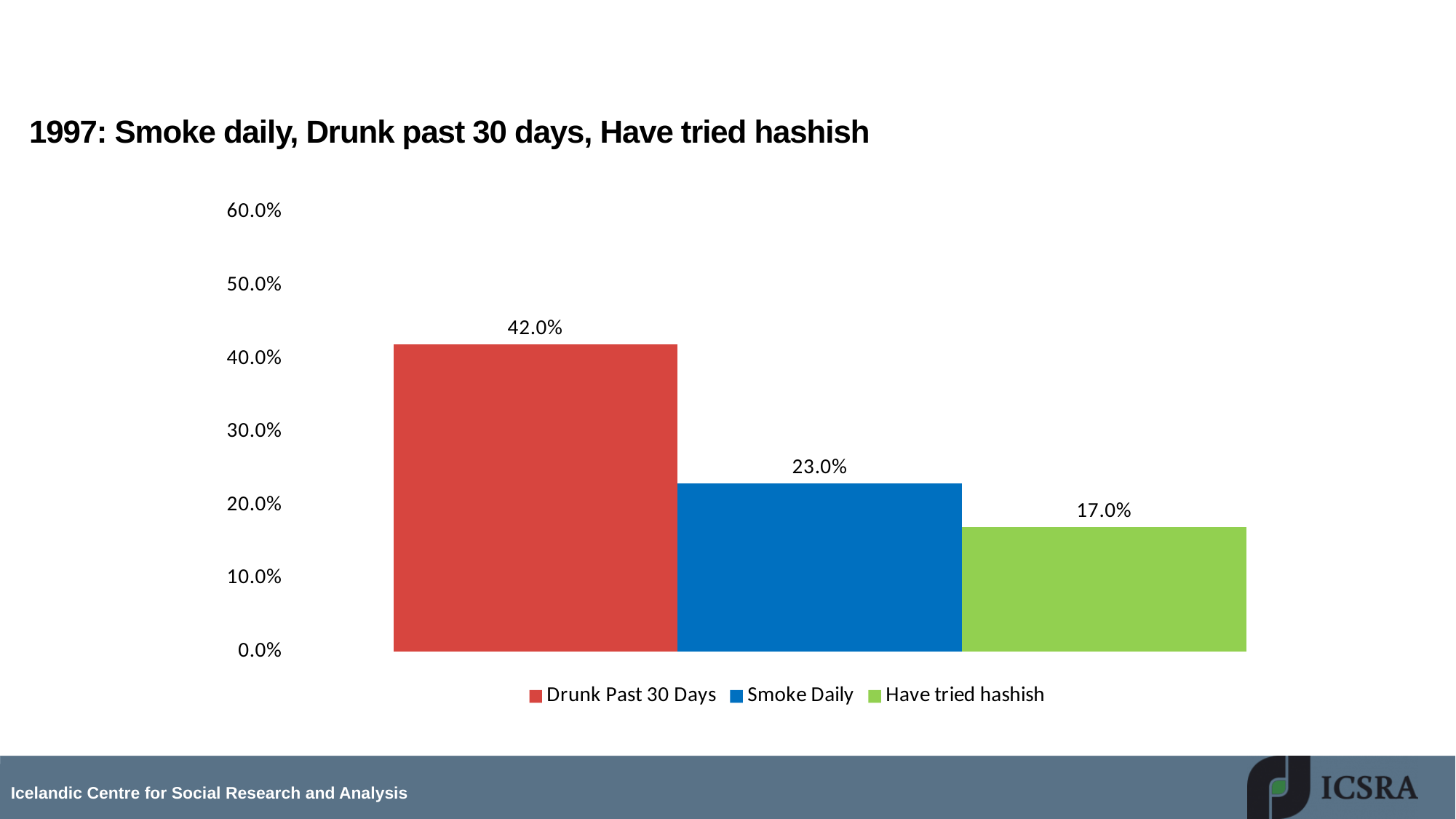
What is the value for Drunk Past 30 Days? 42.0% What is the value for Smoke Daily? 23.0% Which series has the highest value? Drunk Past 30 Days Is the value for Drunk Past 30 Days greater or less than 40.0%? greater How many series does the legend list? 3 What kind of chart is shown on the slide? bar chart What is the difference between the values for Drunk Past 30 Days and Smoke Daily? 19.0% What is the difference between the values for Smoke Daily and Have tried hashish? 6.0% Which series has the lowest value? Have tried hashish What is the value for Have tried hashish? 17.0% What colour is the bar for Smoke Daily? blue Which is larger, the value for Smoke Daily or the value for Have tried hashish? Smoke Daily